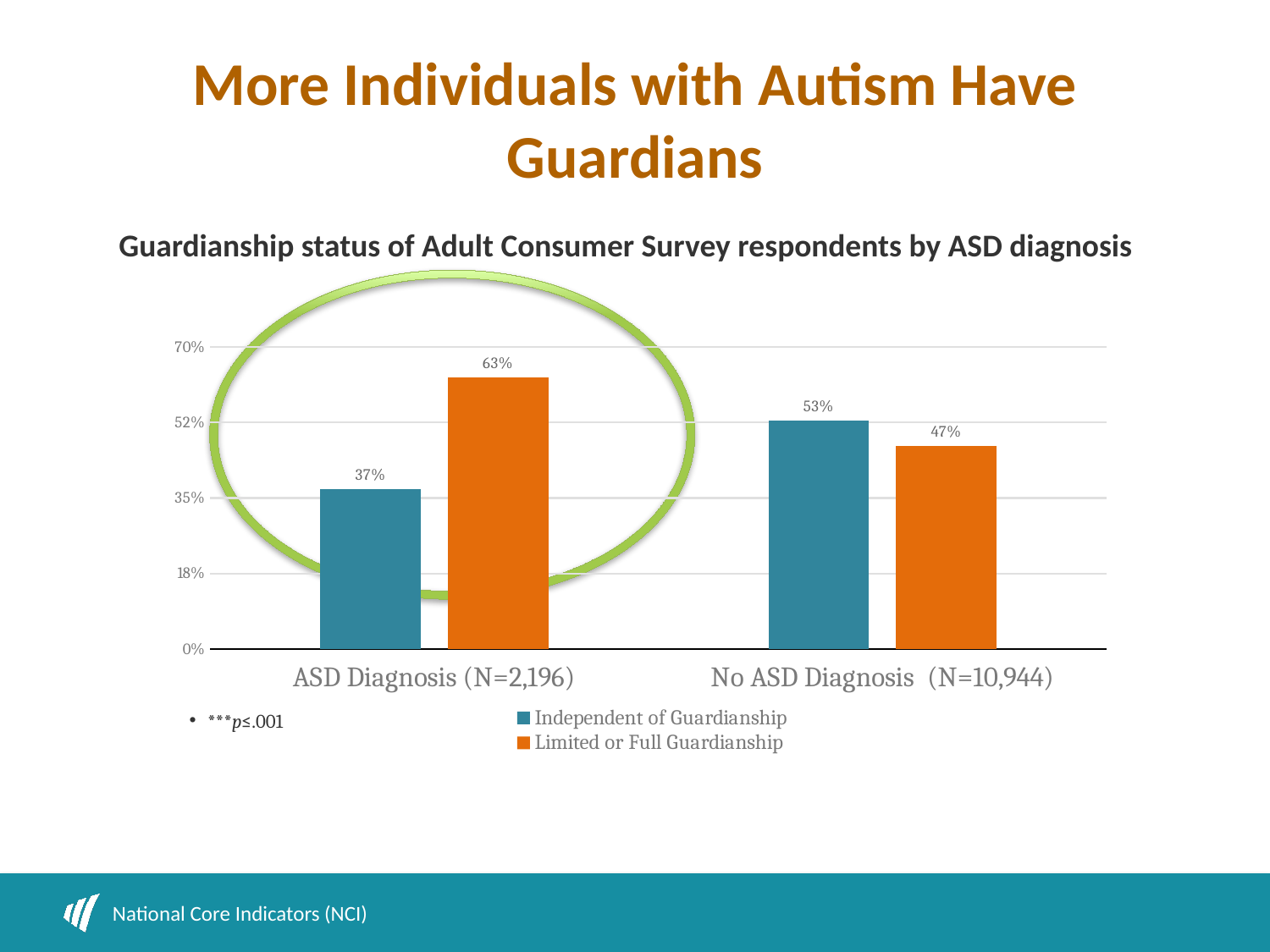
Which group has the highest value for Limited or Full Guardianship? ASD Diagnosis (N=2,196) Which group has the lowest value for Independent of Guardianship? ASD Diagnosis (N=2,196) What percentage of ASD Diagnosis respondents have Limited or Full Guardianship? 63% What percentage of No ASD Diagnosis respondents have Limited or Full Guardianship? 47% How many diagnosis groups are shown on the x axis? 2 What is the difference between Limited or Full Guardianship and Independent of Guardianship for the ASD Diagnosis group? 26% Is the Limited or Full Guardianship value for the ASD Diagnosis group greater or less than 52%? greater Which is larger for the No ASD Diagnosis group: Independent of Guardianship or Limited or Full Guardianship? Independent of Guardianship What kind of chart is shown on the slide? Bar chart What percentage of ASD Diagnosis respondents are Independent of Guardianship? 37% What percentage of No ASD Diagnosis respondents are Independent of Guardianship? 53% How many series does the legend list? 2